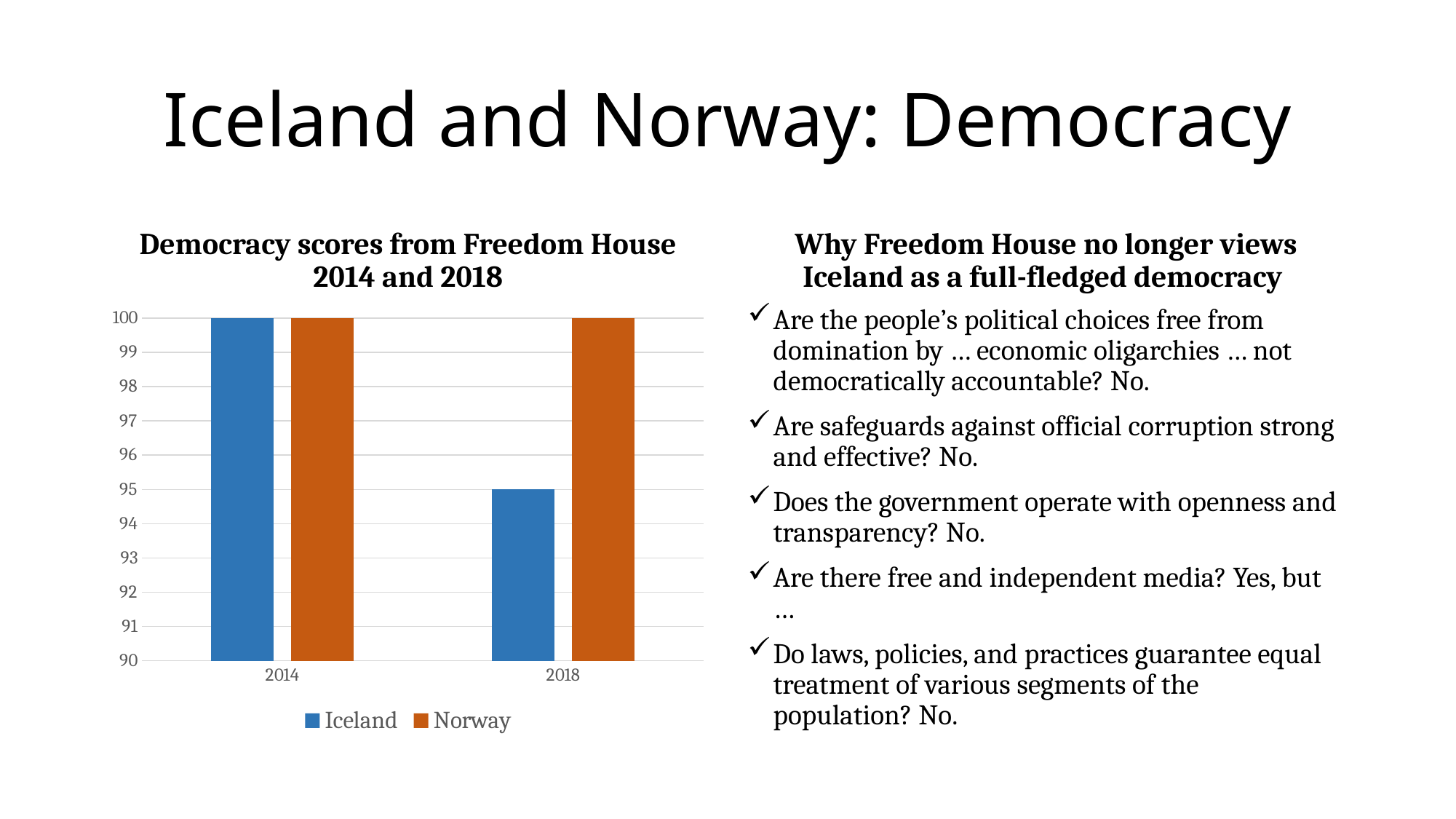
What is Iceland's democracy score in 2014? 100 What is Norway's democracy score in 2018? 100 By how much did Iceland's democracy score fall from 2014 to 2018? 5 By how much does Norway's 2018 score exceed Iceland's 2018 score? 5 What is Norway's democracy score in 2014? 100 What is Iceland's democracy score in 2018? 95 Does Iceland's democracy score rise or fall from 2014 to 2018? fall What type of chart is used to show the democracy scores? bar chart How many series does the chart legend list? 2 How many years are shown on the x axis of the chart? 2 Is Iceland's 2018 score greater or less than 96? less In 2018, which country has the lower democracy score? Iceland